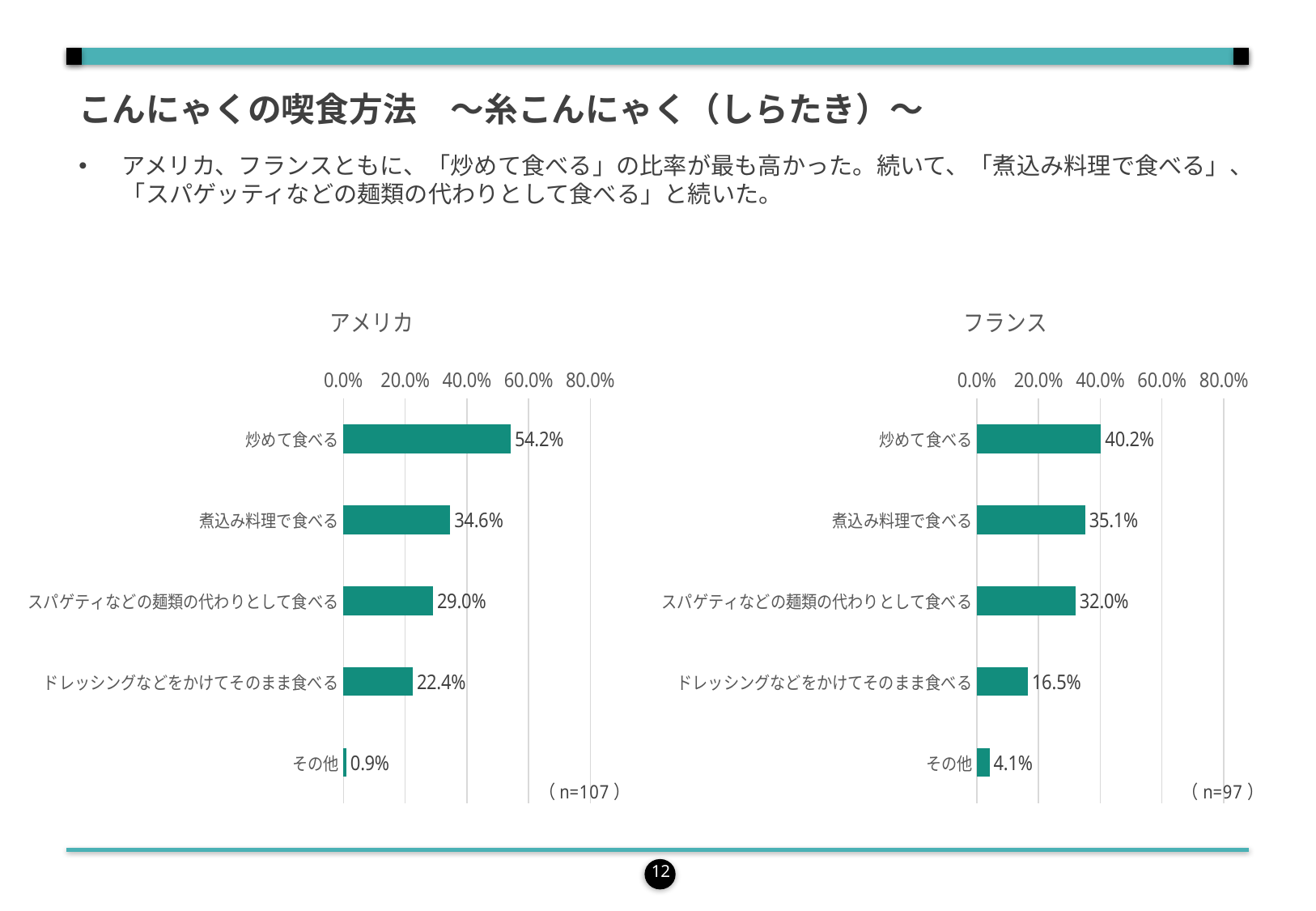
Which is larger: その他 in the アメリカ chart or その他 in the フランス chart? フランス What kind of chart is the フランス chart? bar chart In the フランス chart, what is the value for 煮込み料理で食べる? 35.1% How many categories are shown in the アメリカ chart? 5 In the フランス chart, is the value for 炒めて食べる greater or less than 60.0%? less In the アメリカ chart, which category has the highest value? 炒めて食べる In the アメリカ chart, what is the difference between 煮込み料理で食べる and スパゲティなどの麺類の代わりとして食べる? 5.6% What is the difference between 炒めて食べる in the アメリカ chart and 炒めて食べる in the フランス chart? 14.0% In the フランス chart, what is the value for ドレッシングなどをかけてそのまま食べる? 16.5% What is the sample size (n) shown for the アメリカ chart? n=107 In the アメリカ chart, what is the value for 炒めて食べる? 54.2% In the フランス chart, which category has the lowest value? その他